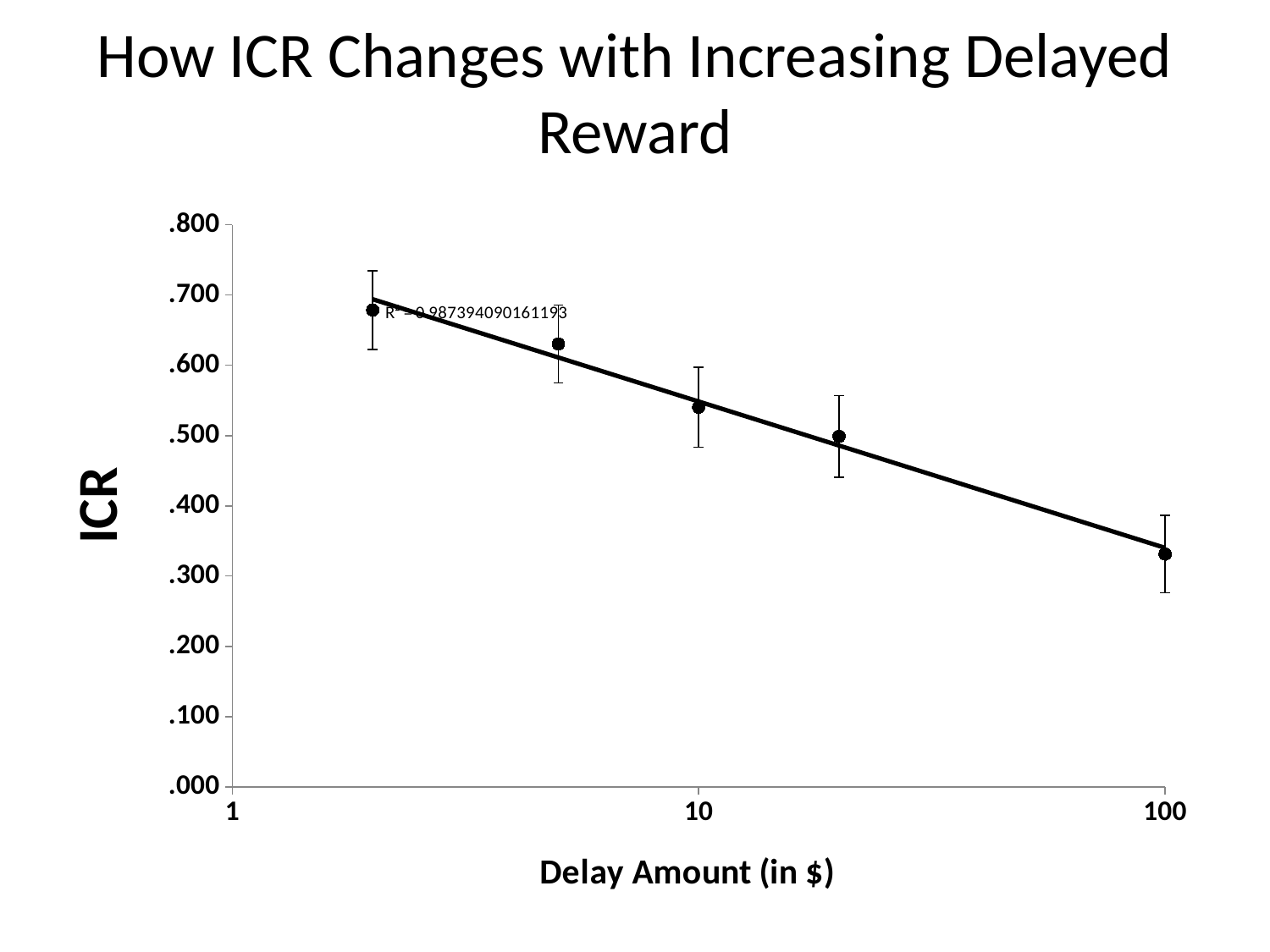
What is the title of the chart? How ICR Changes with Increasing Delayed Reward What kind of chart is shown on the slide? scatter plot with a trendline Do the ICR values rise or fall as the delay amount increases along the x axis? fall Which has the larger ICR value: the point at a delay amount of 10 or the point at a delay amount of 100? 10 At which delay amount is the ICR value lowest? 100 What is the label of the x axis? Delay Amount (in $) Is the ICR value at a delay amount of 10 greater or less than .500? greater How many data points are plotted on the chart? 5 Is the ICR value at a delay amount of 100 greater or less than .400? less